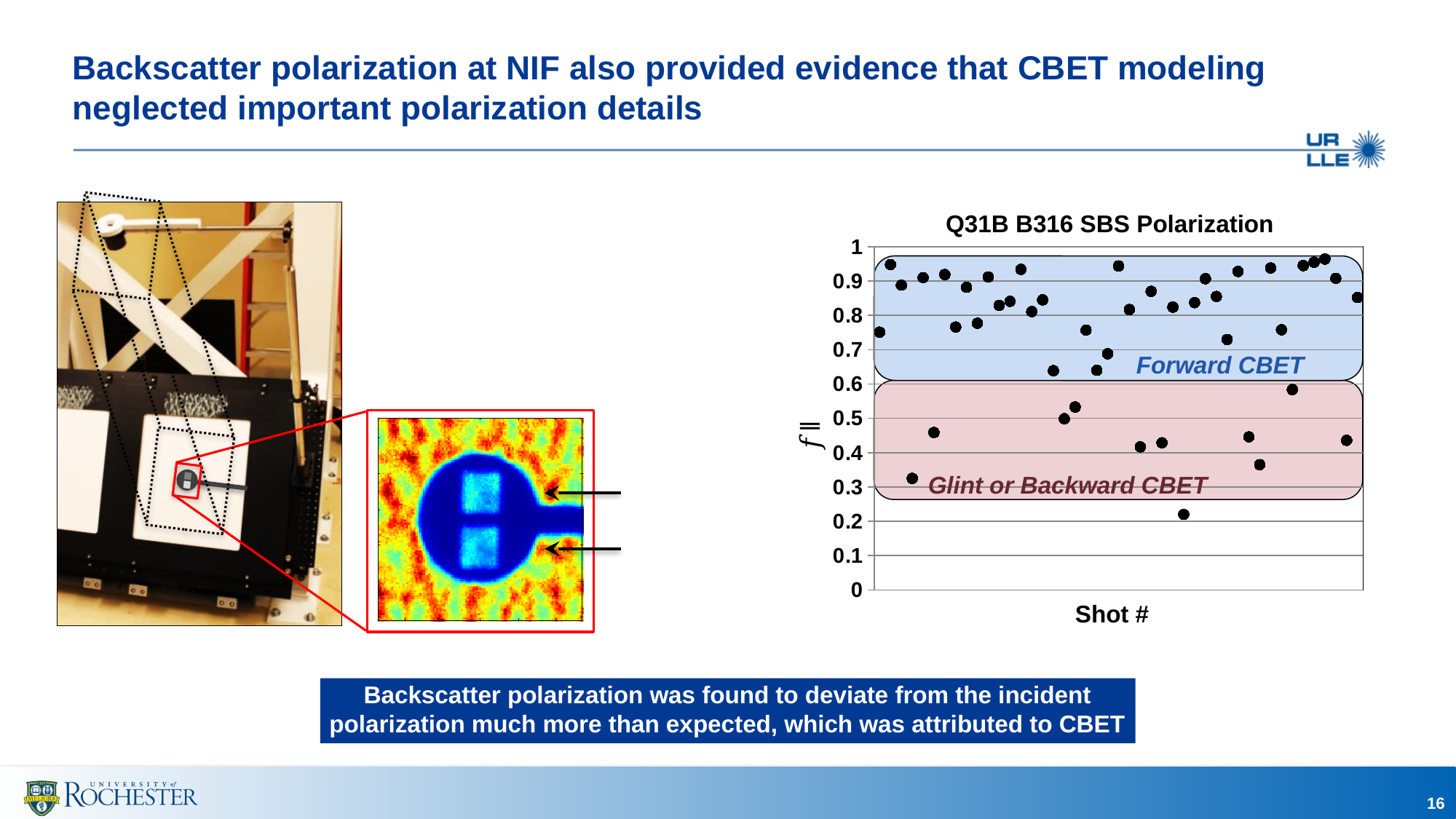
What is the maximum value shown on the y axis of the chart? 1 What label appears inside the blue shaded region of the chart? Forward CBET What kind of chart is shown on the slide? scatter chart What is the title of the chart? Q31B B316 SBS Polarization Is the lowest plotted value in the chart greater or less than 0.3? less What is the minimum value shown on the y axis of the chart? 0 Is the highest plotted value in the chart greater or less than 0.9? greater